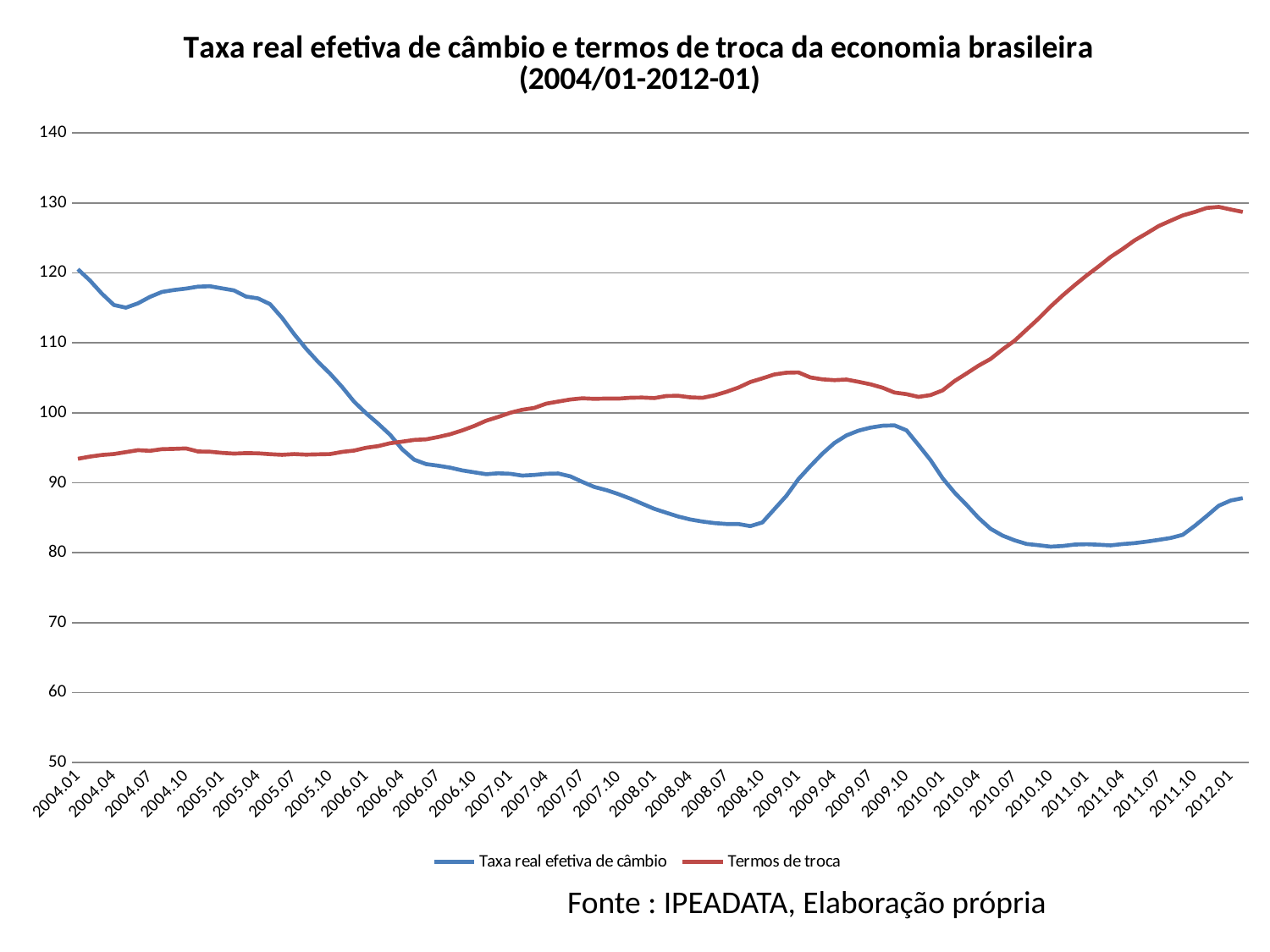
Is the value of Taxa real efetiva de câmbio at 2004.01 greater or less than 110? greater Is the value of Termos de troca at 2012.01 greater or less than 120? greater Is the value of Termos de troca at 2004.01 greater or less than 100? less Does the Termos de troca series rise or fall between 2010.01 and 2012.01? Rises At 2012.01, which series has the higher value, Taxa real efetiva de câmbio or Termos de troca? Termos de troca At 2004.01, which series has the higher value, Taxa real efetiva de câmbio or Termos de troca? Taxa real efetiva de câmbio What kind of chart is shown on the slide? Line chart How many series does the legend list? 2 What are the two series named in the legend? Taxa real efetiva de câmbio and Termos de troca What is the title of the chart? Taxa real efetiva de câmbio e termos de troca da economia brasileira (2004/01-2012-01)